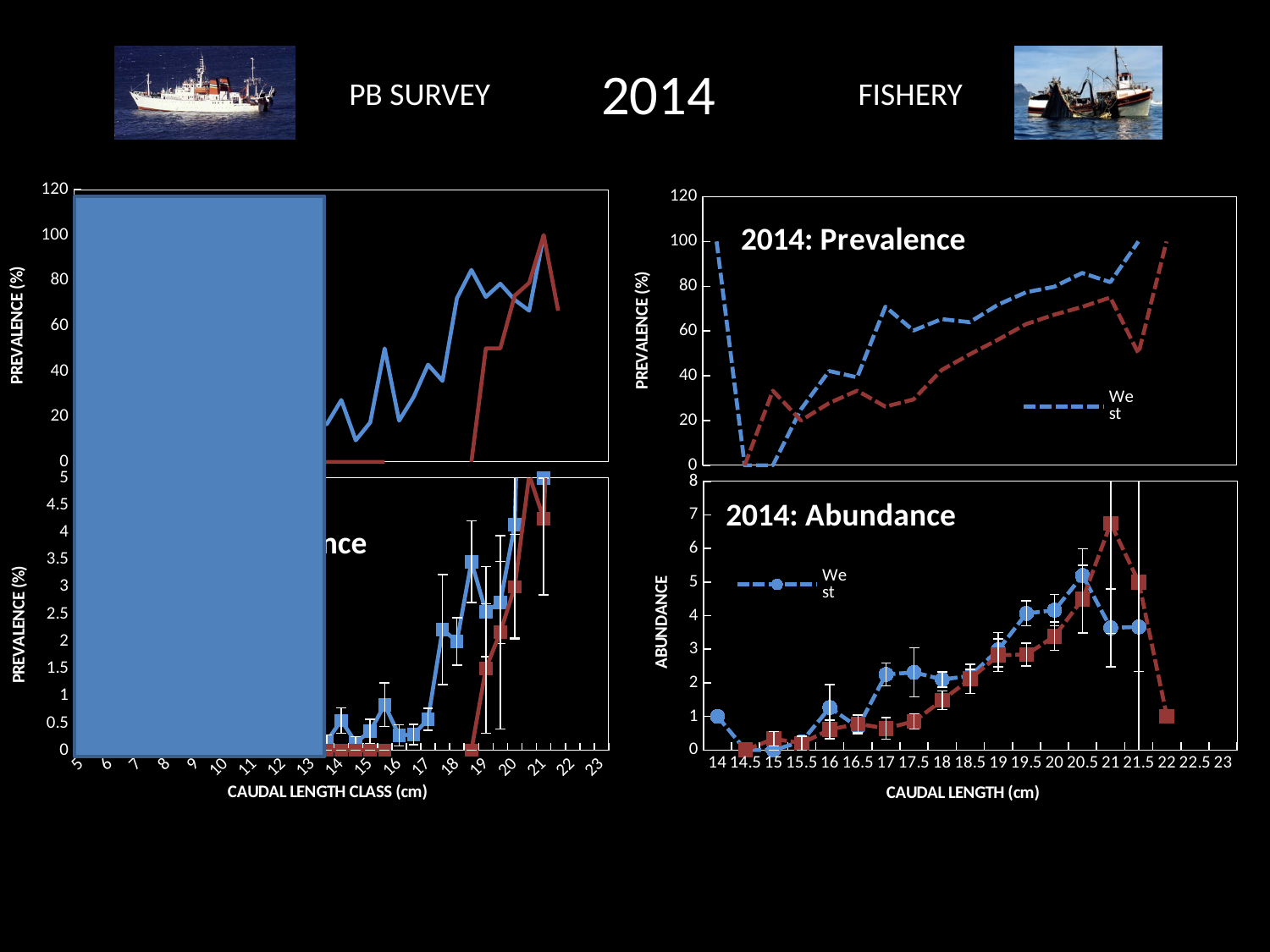
In the '2014: Abundance' chart, is the West value at caudal length 20.5 greater or less than 4? greater In the '2014: Abundance' chart, how many series does the legend list? 1 What is the title of the top-right chart? 2014: Prevalence In the '2014: Abundance' chart, is the West value at caudal length 19.5 greater or less than 3? greater What kind of chart is the '2014: Abundance' chart on the right of the slide? line chart In the '2014: Abundance' chart, is the West value at caudal length 15 greater or less than 1? less In the '2014: Abundance' chart, do the West values generally rise or fall from caudal length 15 to 20.5? rise In the '2014: Abundance' chart, how many caudal length tick labels are shown on the x axis? 19 In the '2014: Abundance' chart, what is the y-axis title? ABUNDANCE In the '2014: Prevalence' chart, do the West values generally rise or fall from the dip near the left to the right end of the chart? rise In the '2014: Abundance' chart, which is larger for the West series: the value at caudal length 20.5 or at 21? 20.5